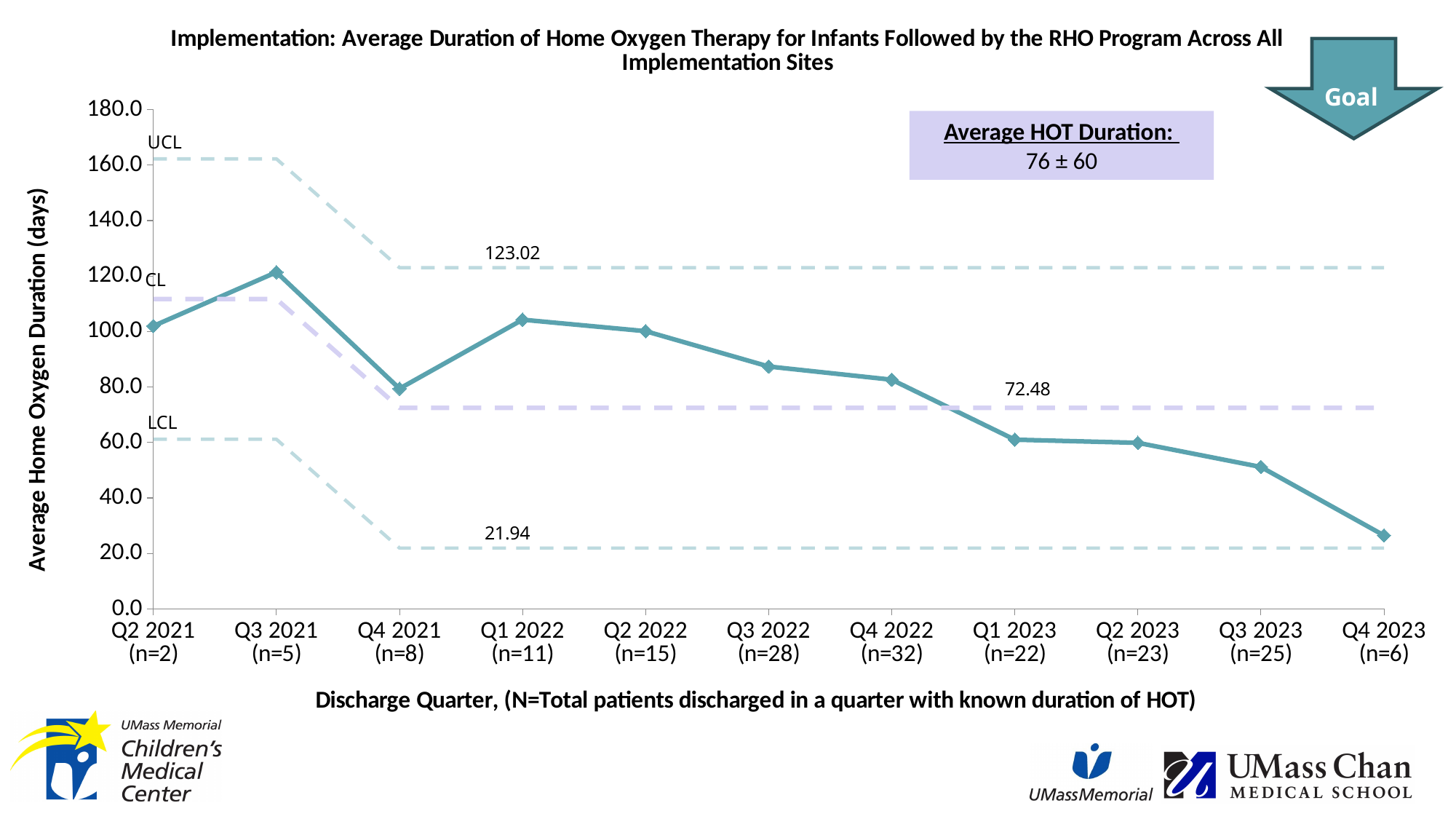
From Q1 2022 to Q4 2023, does the average home oxygen duration rise or fall? fall How many discharge quarters are plotted on the x axis? 11 What is the difference between the labelled UCL (123.02) and LCL (21.94) values from Q4 2021 onward? 101.08 Which discharge quarter has the lowest average home oxygen duration? Q4 2023 Is the average home oxygen duration for Q4 2023 greater or less than 40? less What is the labelled value of the upper control limit (UCL) from Q4 2021 onward? 123.02 What is the labelled value of the lower control limit (LCL) from Q4 2021 onward? 21.94 What is the labelled value of the center line (CL) from Q4 2021 onward? 72.48 Is the average home oxygen duration for Q3 2021 greater or less than 100? greater Which is larger, the average home oxygen duration for Q1 2022 or for Q3 2022? Q1 2022 What kind of chart is shown on the slide? line chart Which discharge quarter has the highest average home oxygen duration? Q3 2021